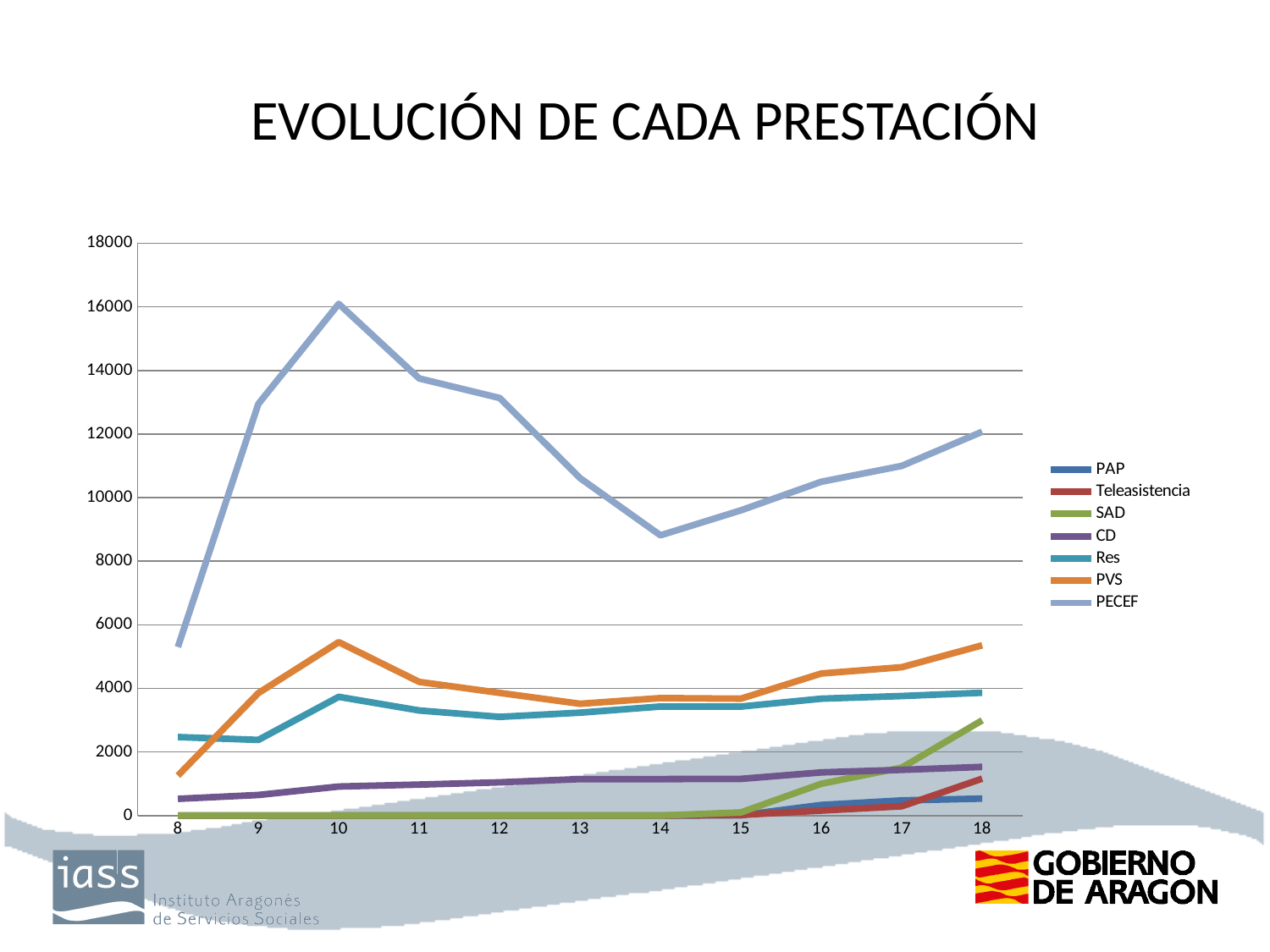
What is the title of the chart? EVOLUCIÓN DE CADA PRESTACIÓN At 18, which is larger, PVS or Res? PVS At which x-axis value does the PECEF series reach its peak? 10 How many series does the legend list? 7 Is the value for PVS at 10 greater or less than 4000? greater What kind of chart is shown on the slide? line chart Is the value for PECEF at 10 greater or less than 14000? greater Does the PECEF series rise or fall between 10 and 14? fall Which series has the highest values across the chart? PECEF Does the PECEF series rise or fall between 14 and 18? rise Is the value for PECEF at 14 greater or less than 10000? less How many points are there along the x axis? 11